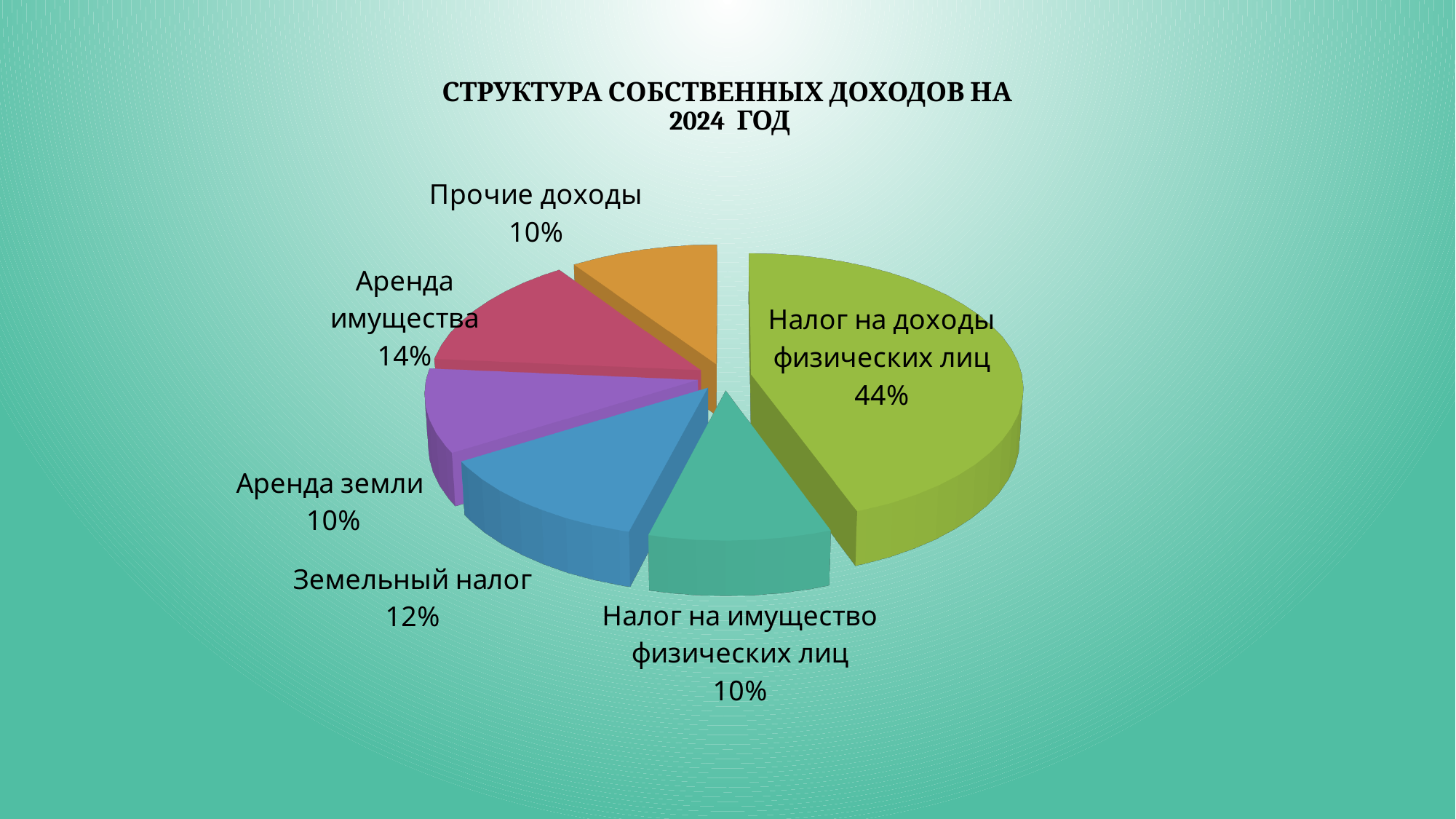
What is the value shown for Земельный налог? 12% What type of chart is shown on the slide? Pie chart What is the title of the chart? СТРУКТУРА СОБСТВЕННЫХ ДОХОДОВ НА 2024 ГОД What is the value shown for Налог на имущество физических лиц? 10% What share of the pie is Налог на доходы физических лиц? 44% Which category has the largest share of the pie? Налог на доходы физических лиц What colour is the slice for Налог на доходы физических лиц? Green What is the value shown for Аренда имущества? 14% How many slices does the pie chart have? 6 What is the value shown for Аренда земли? 10% What is the difference between the shares of Налог на доходы физических лиц and Аренда имущества? 30% Which is larger, Земельный налог or Прочие доходы? Земельный налог